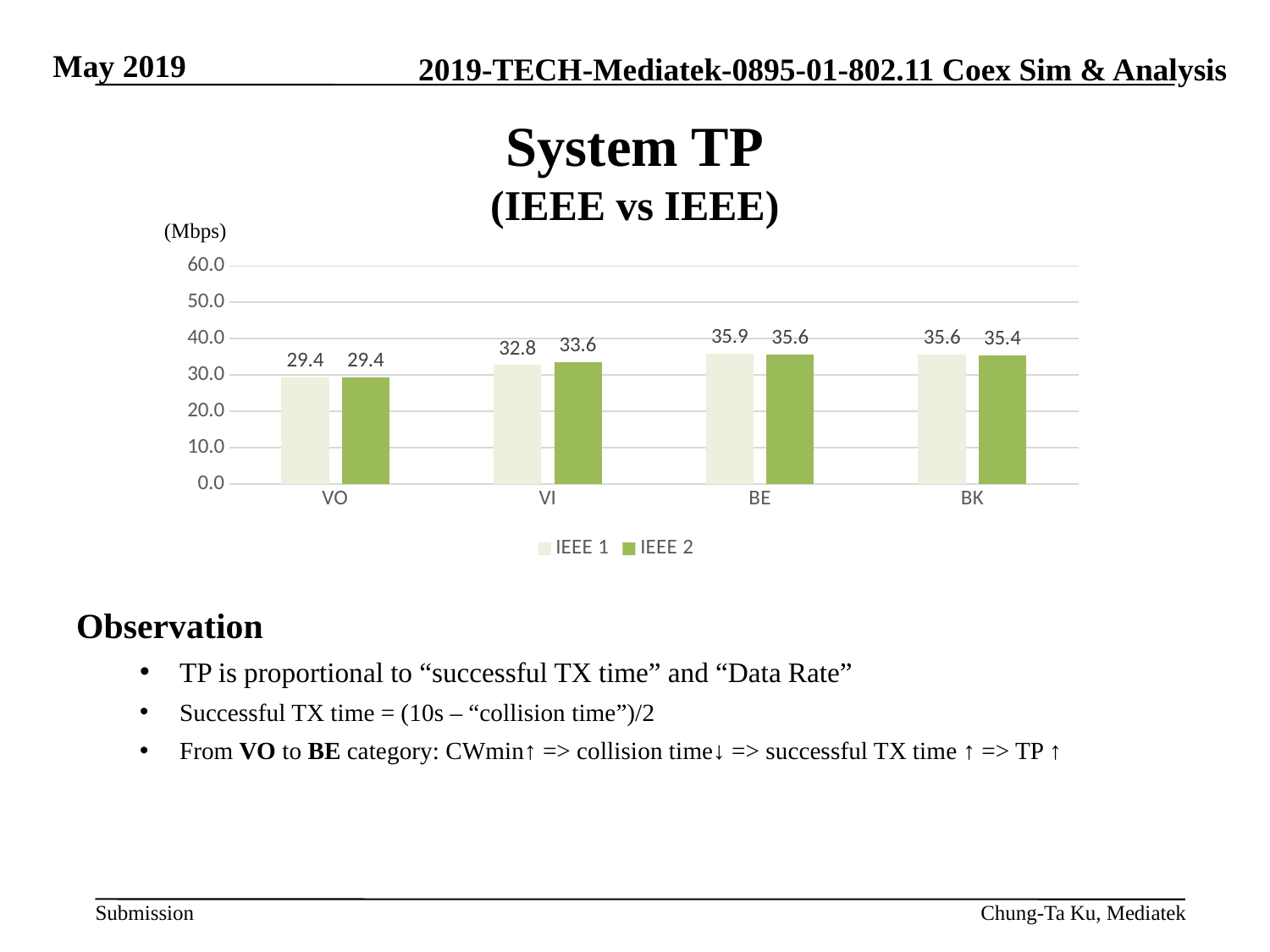
What is the IEEE 1 value for VO? 29.4 How many categories are shown on the x axis? 4 Which category has the lowest IEEE 1 value? VO What unit is shown for the y axis of the chart? Mbps What is the IEEE 2 value for BK? 35.4 What is the difference between the IEEE 2 values for VI and VO? 4.2 Which is larger for VI, the IEEE 1 value or the IEEE 2 value? IEEE 2 Which category has the highest IEEE 1 value? BE What is the IEEE 1 value for BE? 35.9 What kind of chart is shown on the slide? bar chart What is the IEEE 2 value for VI? 33.6 How many series does the legend list? 2